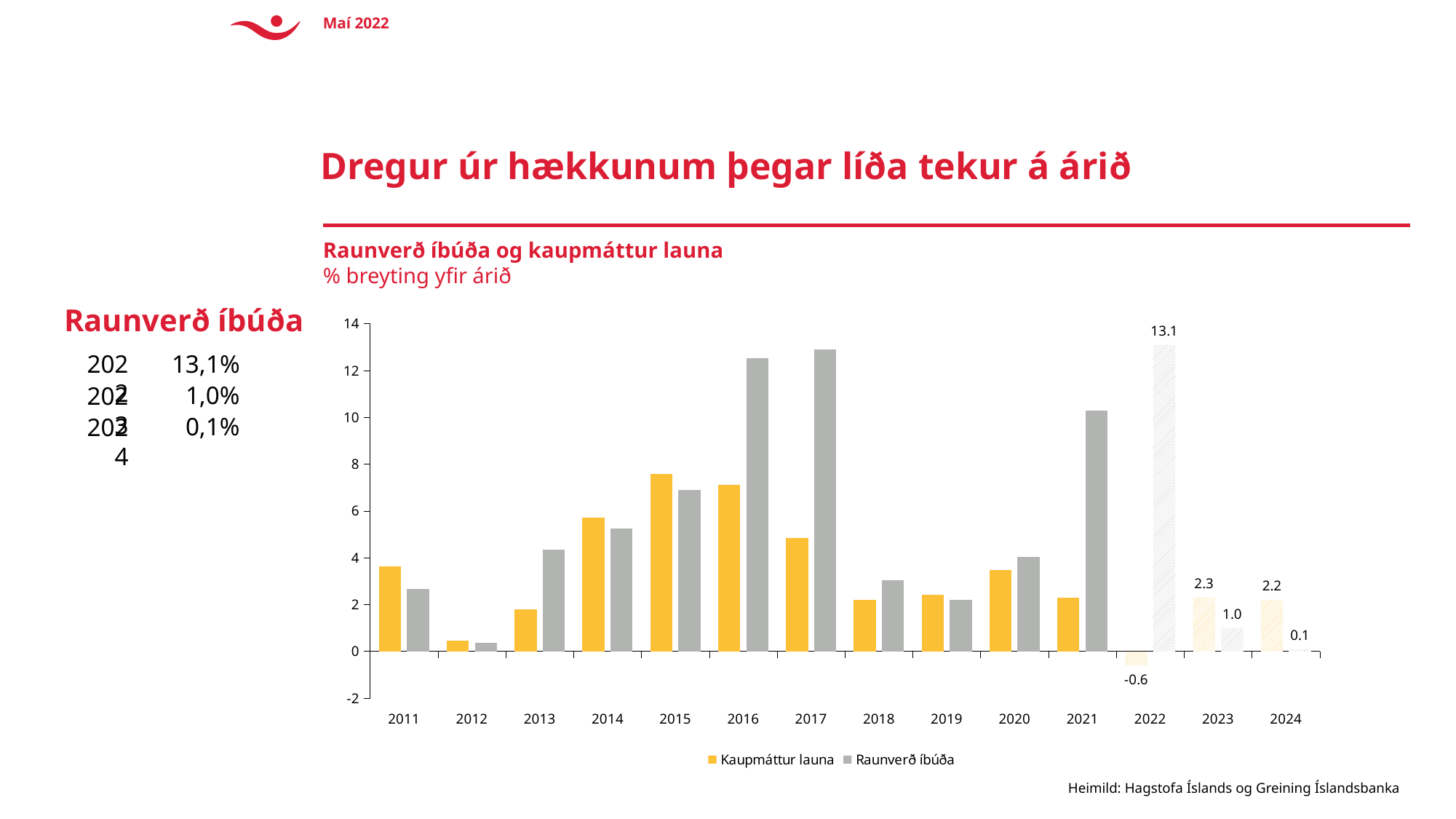
What kind of chart is shown on the slide? bar chart How many years are shown on the x axis of the chart? 14 Which year has the highest value for Raunverð íbúða? 2022 What is the value for Raunverð íbúða in 2022? 13.1 What is the difference between Raunverð íbúða and Kaupmáttur launa in 2023? 1.3 What is the title of the chart? Raunverð íbúða og kaupmáttur launa Which is larger in 2017, Kaupmáttur launa or Raunverð íbúða? Raunverð íbúða Is the value for Raunverð íbúða in 2021 greater or less than 10? greater How many series does the chart legend list? 2 What is the value for Raunverð íbúða in 2024? 0.1 What is the value for Kaupmáttur launa in 2022? -0.6 What is the value for Kaupmáttur launa in 2023? 2.3